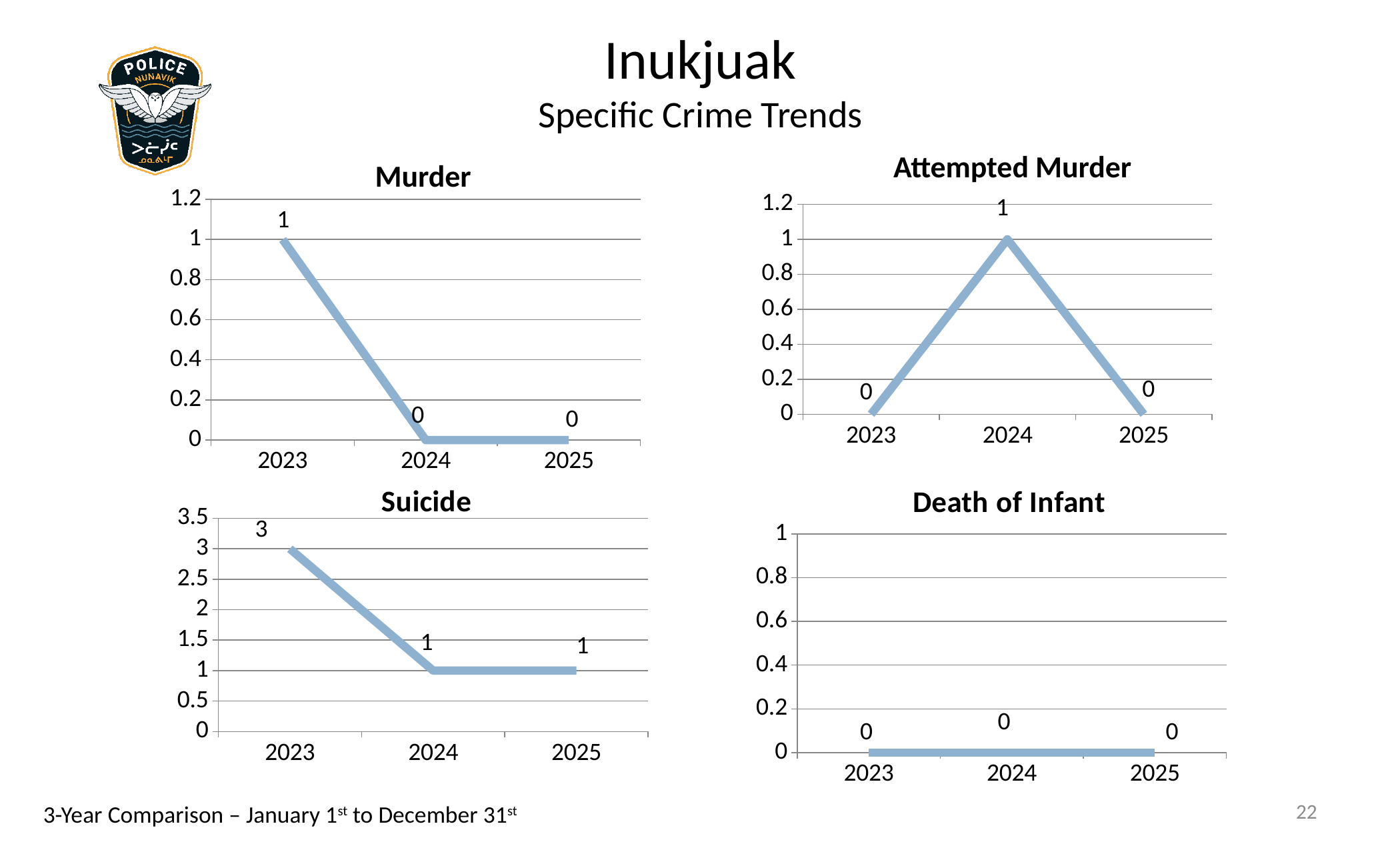
In the Suicide chart, what is the difference between the 2023 and 2024 values? 2 In the Suicide chart, do the values rise or fall from 2023 to 2024? fall In the Murder chart, what is the value for 2023? 1 In the Murder chart, is the value for 2023 larger than the value for 2025? yes In the Attempted Murder chart, which year has the highest value? 2024 How many years are plotted in the Murder chart? 3 What kind of chart is the Attempted Murder chart? line chart In the Attempted Murder chart, what is the value for 2024? 1 In the Suicide chart, what is the value for 2023? 3 In the Suicide chart, which year has the highest value? 2023 In the Death of Infant chart, what is the value for 2025? 0 In the Murder chart, what is the value for 2024? 0